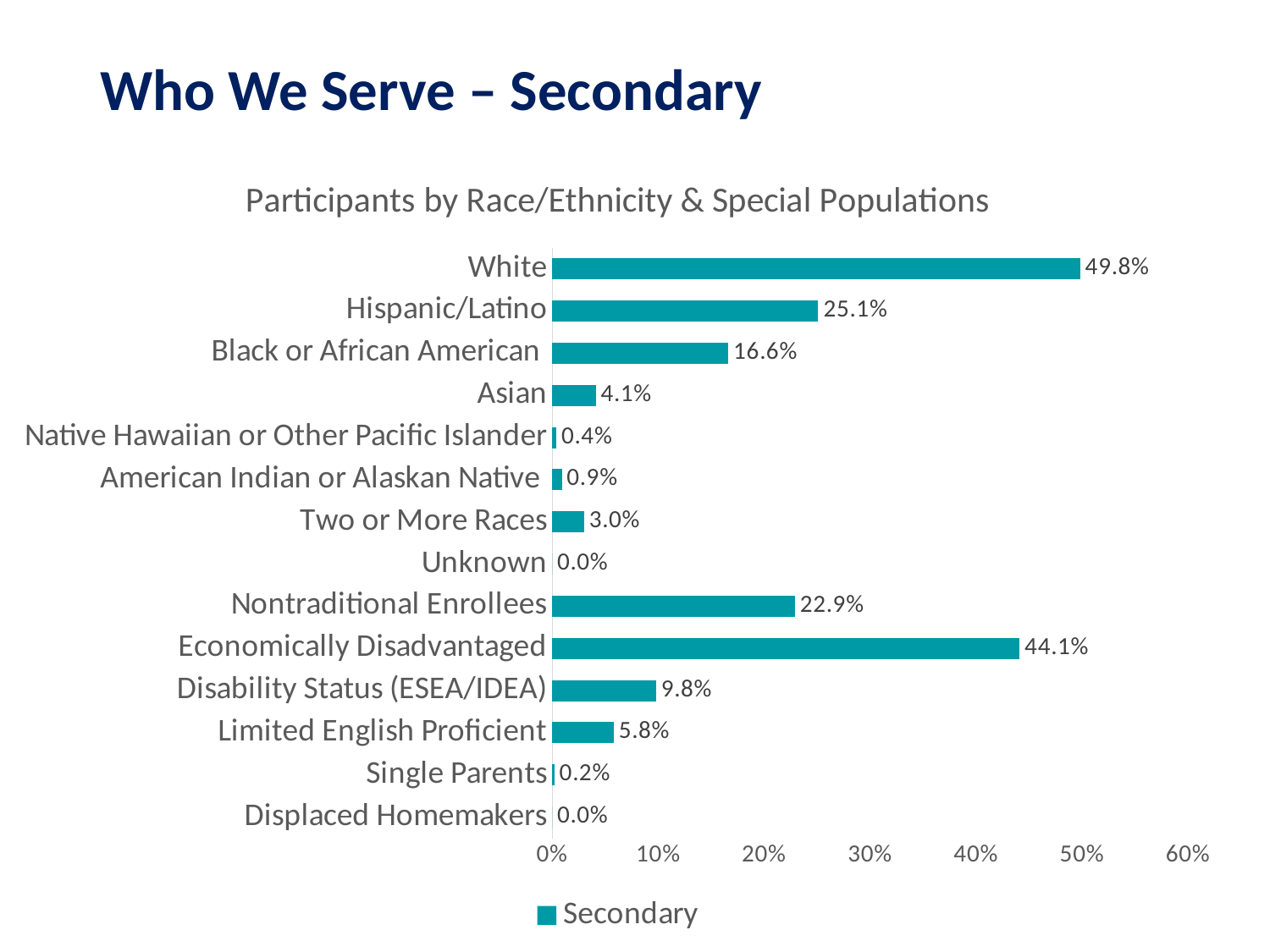
What is the difference between the values for Hispanic/Latino and Black or African American? 8.5% Which category has the highest value? White Which is larger, the value for Nontraditional Enrollees or the value for Hispanic/Latino? Hispanic/Latino What is the name of the series in the legend? Secondary What is the title of the chart? Participants by Race/Ethnicity & Special Populations What is the value for Economically Disadvantaged? 44.1% Is the value for Economically Disadvantaged greater or less than 40%? greater How many series does the legend list? 1 How many categories are shown on the chart? 14 What is the value for White? 49.8% What kind of chart is shown on the slide? bar chart What is the value for Limited English Proficient? 5.8%